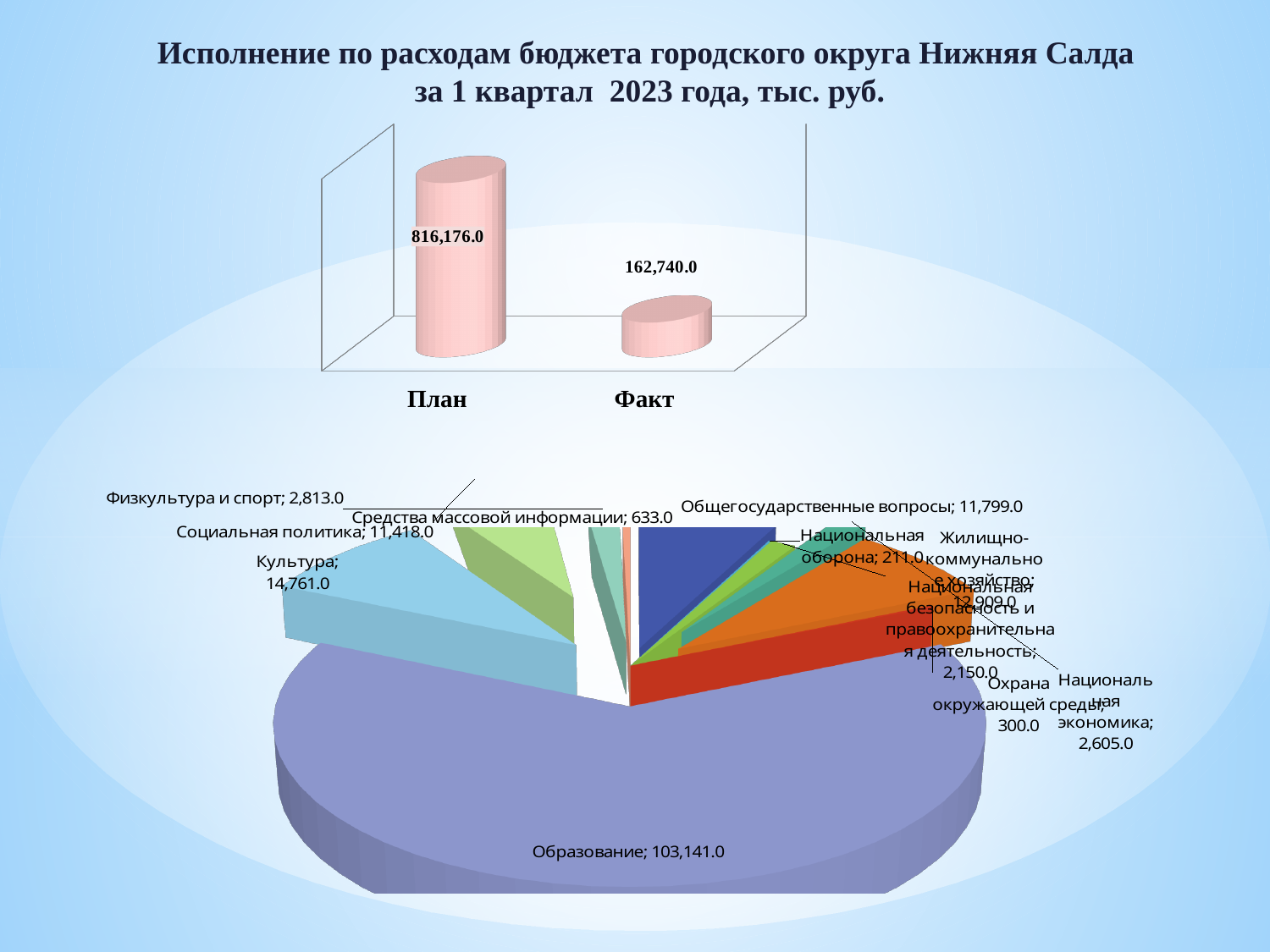
In the top chart, which is larger, План or Факт? План In the top chart, what is the difference between План and Факт? 653,436.0 In the bottom pie chart, which category has the largest value? Образование What kind of chart is the top chart on the slide? Bar chart In the bottom pie chart, which is larger, Социальная политика or Общегосударственные вопросы? Общегосударственные вопросы In the bottom pie chart, what is the value for Культура? 14,761.0 In the bottom pie chart, which category has the smallest value? Национальная оборона What kind of chart is the bottom chart on the slide? Pie chart In the bottom pie chart, what is the value for Образование? 103,141.0 In the bottom pie chart, what is the value for Национальная оборона? 211.0 In the top chart, what is the value for План? 816,176.0 In the top chart, what is the value for Факт? 162,740.0